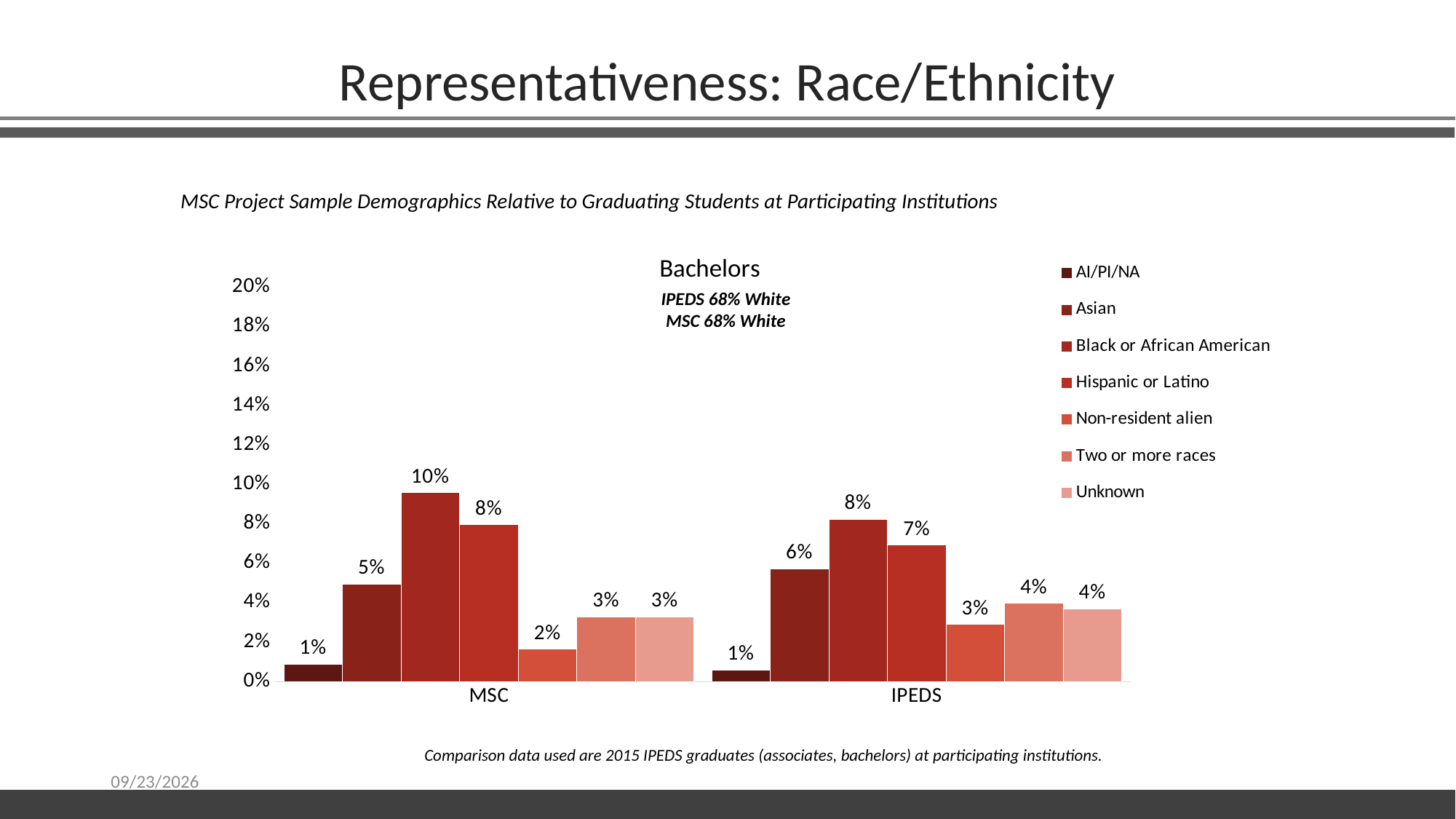
What is the value for Black or African American in the MSC category? 10% What is the value for Asian in the IPEDS category? 6% Which series has the lowest value in the IPEDS category? AI/PI/NA How many categories are shown on the x axis? 2 Which series has the highest value in the MSC category? Black or African American What kind of chart is shown on the slide? bar chart How many series does the legend list? 7 Is the value for Asian in the MSC category greater or less than 4%? greater What is the title of the chart? Bachelors What is the value for Non-resident alien in the MSC category? 2% Which is larger, the Hispanic or Latino value for MSC or for IPEDS? MSC What is the difference between the Black or African American values for MSC and IPEDS? 2%